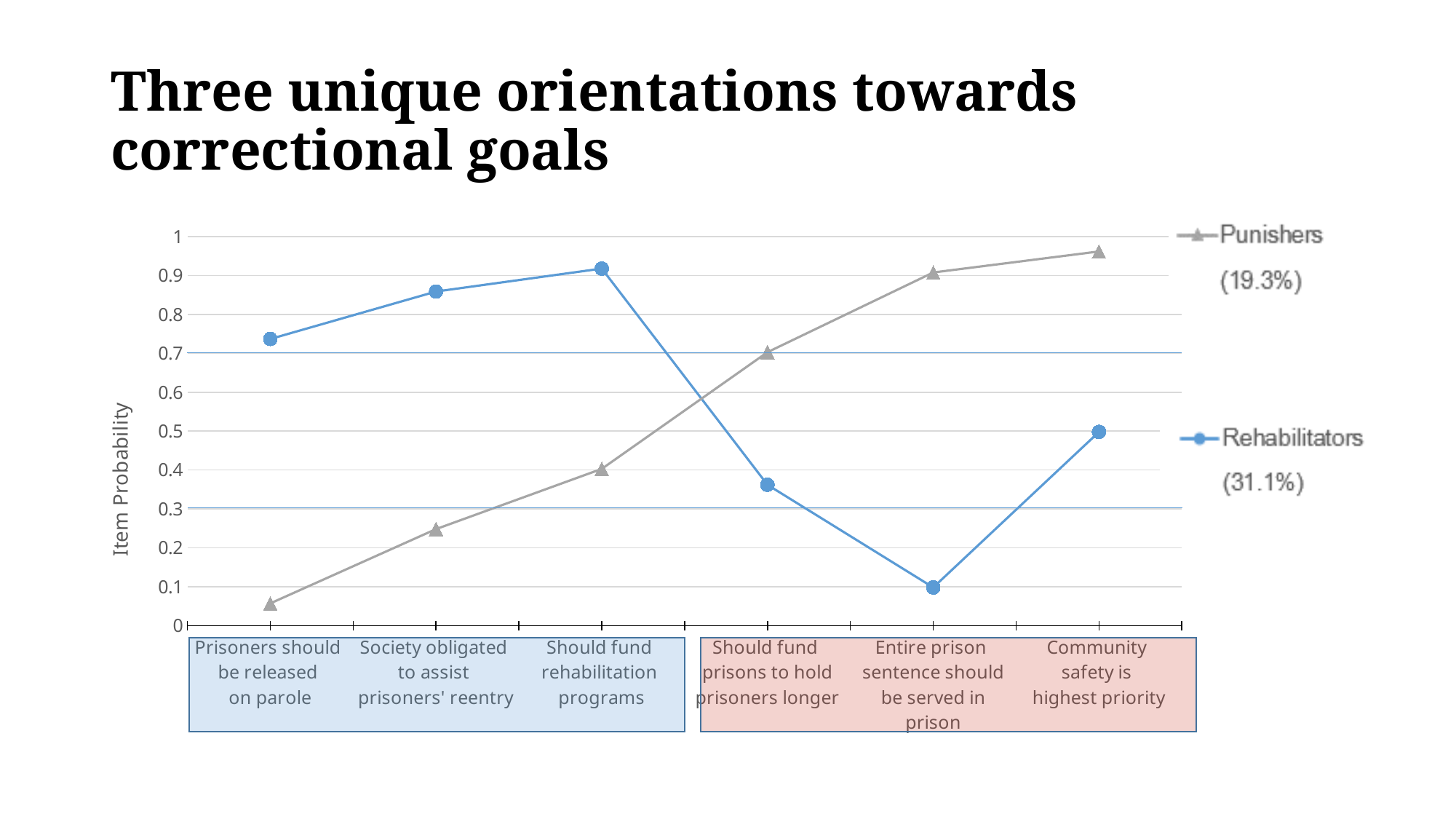
For 'Community safety is highest priority', which series has the larger value, Punishers or Rehabilitators? Punishers Is the Rehabilitators value for 'Entire prison sentence should be served in prison' greater or less than 0.2? less Which category has the highest value for the Punishers series? Community safety is highest priority Do the Punishers values rise or fall moving left to right along the x axis? rise How many categories are plotted along the x axis? 6 What kind of chart is shown on the slide? line chart How many series does the legend list? 2 Is the Rehabilitators value for 'Should fund rehabilitation programs' greater or less than 0.8? greater Which category has the lowest value for the Rehabilitators series? Entire prison sentence should be served in prison Is the Punishers value for 'Prisoners should be released on parole' greater or less than 0.1? less What percentage is shown next to the Punishers legend entry? 19.3% Which category has the lowest value for the Punishers series? Prisoners should be released on parole